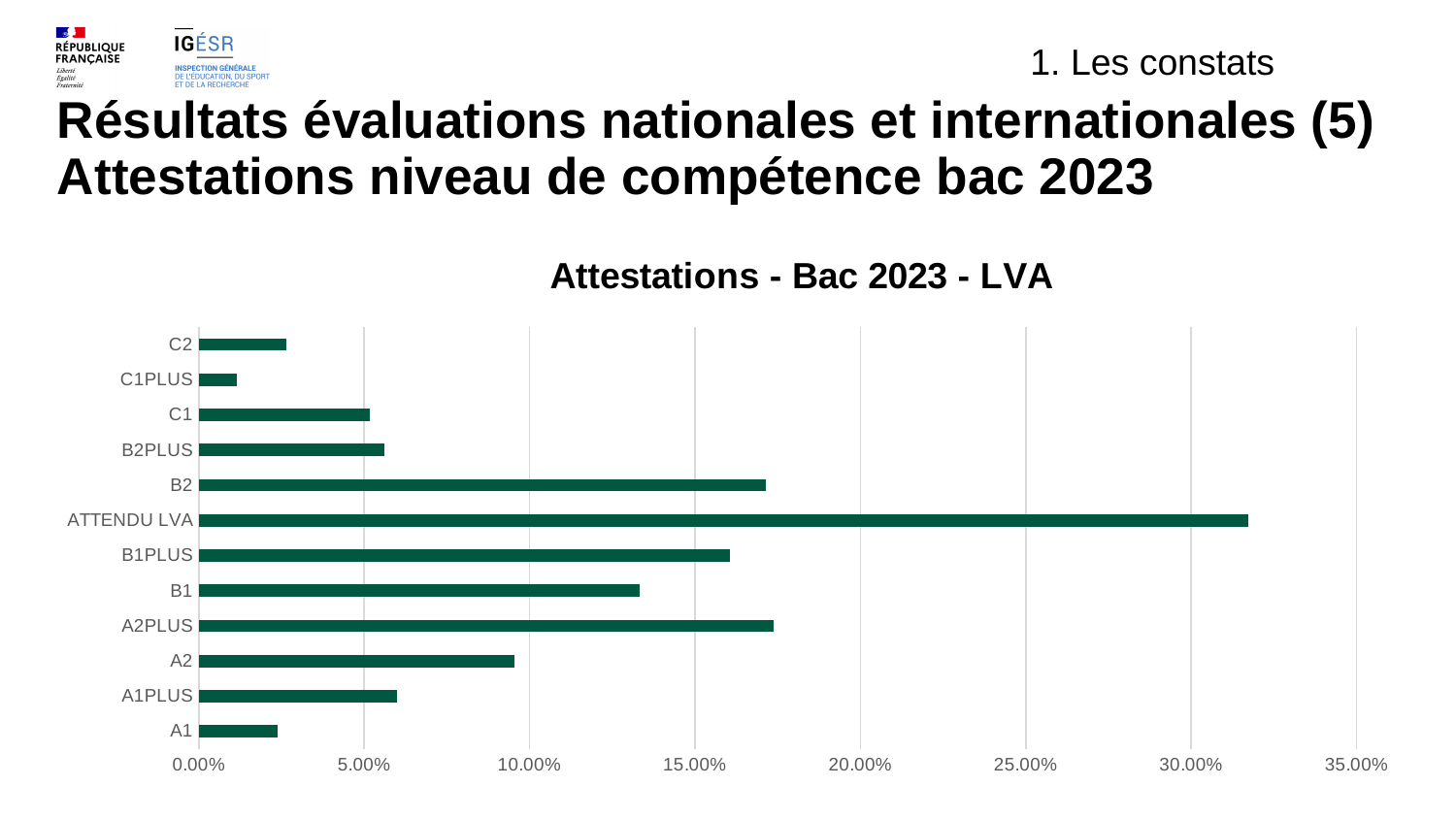
Which category has the lowest value? C1PLUS Is the value for B1 greater or less than 10.00%? greater How many categories are plotted on the chart? 12 What is the title of the chart? Attestations - Bac 2023 - LVA Is the value for C1PLUS greater or less than 5.00%? less Which is larger, the value for B2 or the value for B1? B2 Is the value for B2 greater or less than 15.00%? greater What type of chart is shown on the slide? Bar chart Which is larger, the value for A1PLUS or the value for A1? A1PLUS Which category has the highest value? ATTENDU LVA